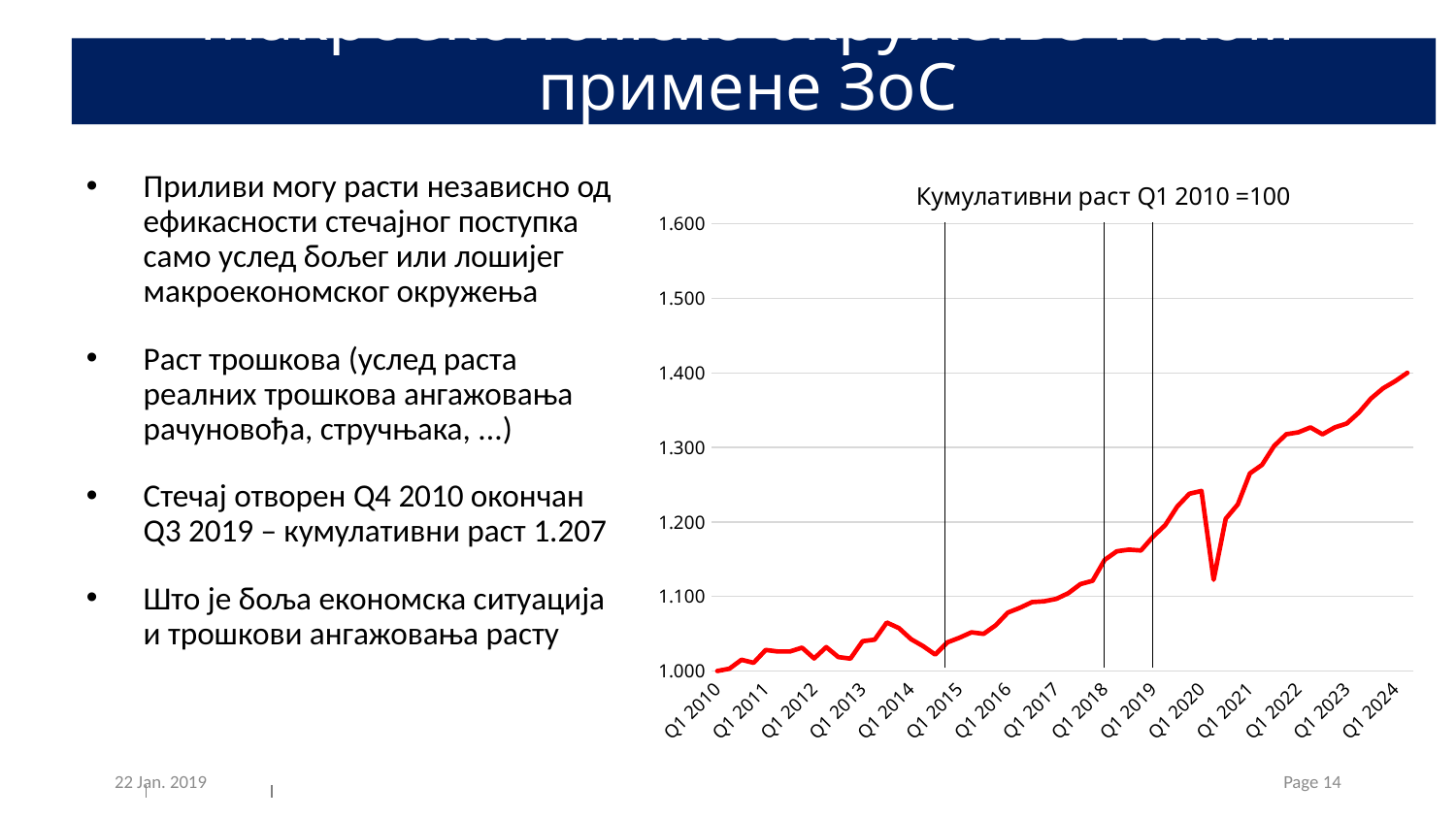
Which of the labelled quarters on the x axis has the highest value? Q1 2024 Is the value for Q1 2022 greater or less than 1.400? less Which is larger, the value for Q1 2024 or the value for Q1 2010? Q1 2024 What kind of chart is shown on the slide? line chart Is the value for Q1 2015 greater or less than 1.100? less Is the value for Q1 2024 greater or less than 1.300? greater What is the title of the chart? Кумулативни раст Q1 2010 =100 Do the values on the chart generally rise or fall from Q1 2010 to Q1 2024? rise Which of the labelled quarters on the x axis has the lowest value? Q1 2010 How many quarter labels are shown on the x axis? 15